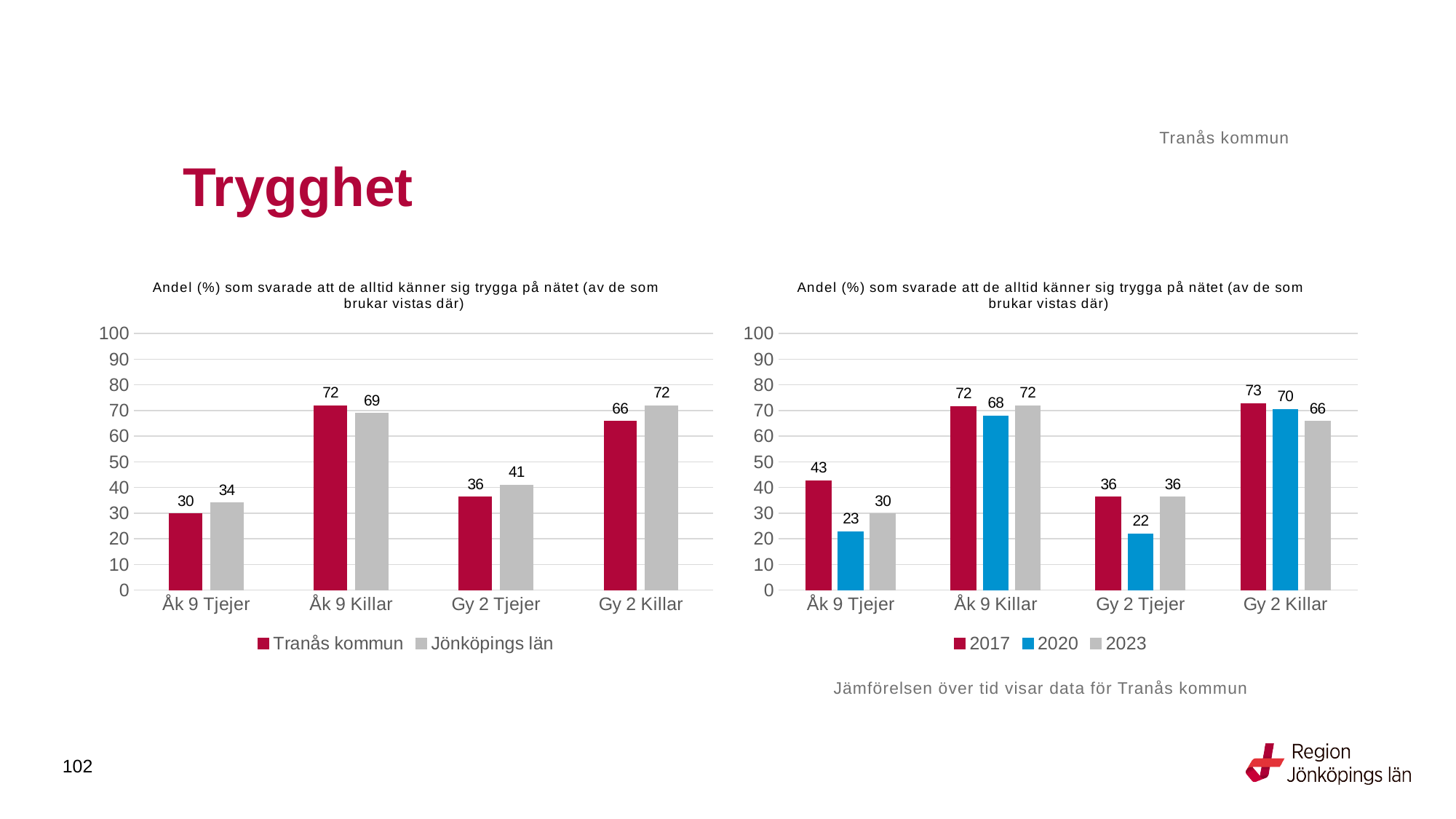
In the right chart, what is the difference between the 2017 and 2023 values for Åk 9 Tjejer? 13 In the right chart, what is the value for 2017 for Åk 9 Tjejer? 43 In the left chart, what is the value for Jönköpings län for Gy 2 Tjejer? 41 In the right chart, what is the value for 2020 for Gy 2 Tjejer? 22 In the right chart, which category has the lowest value for 2020? Gy 2 Tjejer In the left chart, which category has the highest value for Tranås kommun? Åk 9 Killar In the left chart, what is the value for Tranås kommun for Åk 9 Tjejer? 30 In the left chart, which is larger for Åk 9 Killar: Tranås kommun or Jönköpings län? Tranås kommun What kind of chart is the right chart? Bar chart How many categories are shown on the x axis of the right chart? 4 How many series does the legend of the left chart list? 2 In the left chart, what is the difference between Jönköpings län and Tranås kommun for Gy 2 Killar? 6